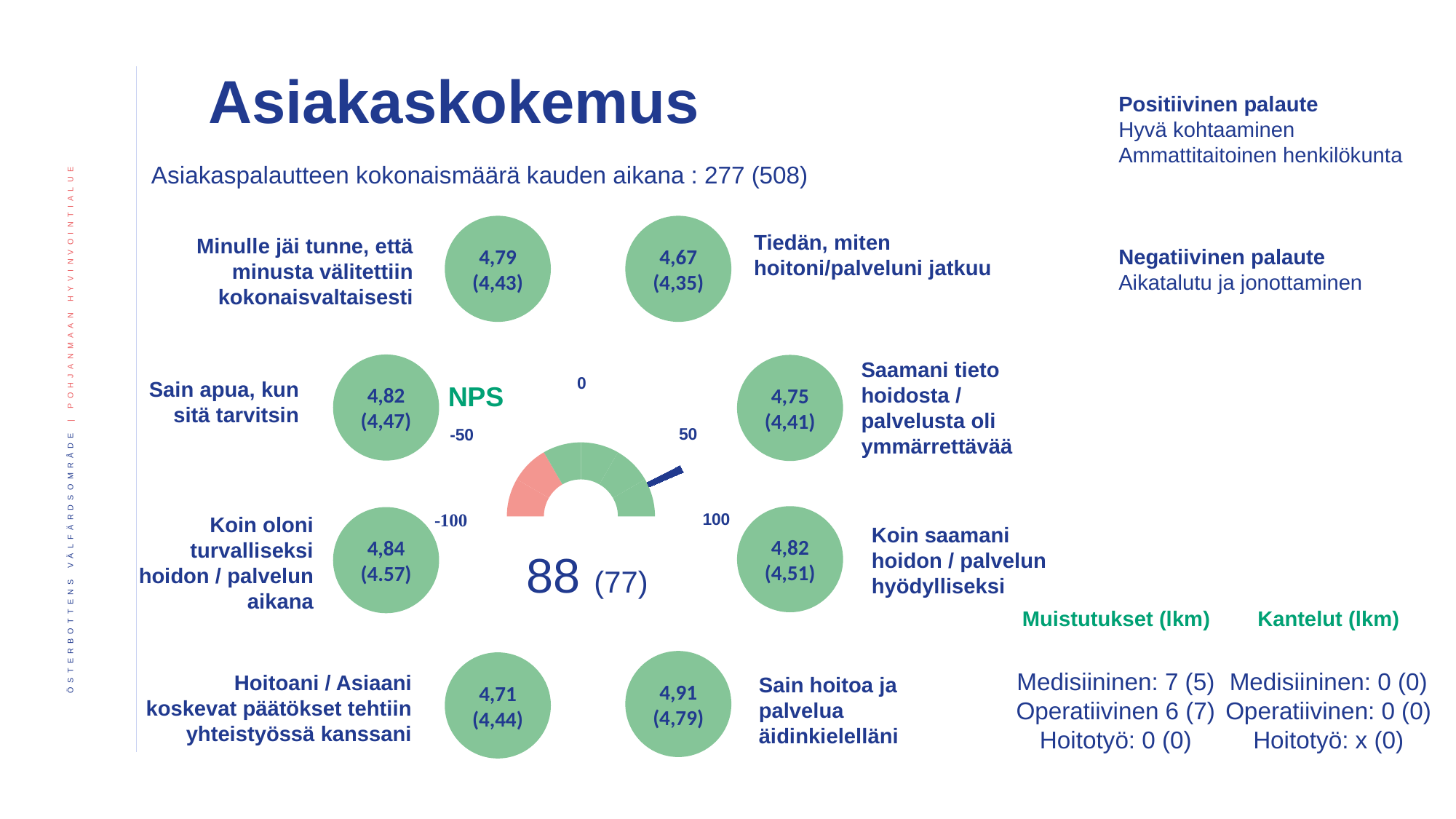
What is the score shown for 'Tiedän, miten hoitoni/palveluni jatkuu'? 4,67 Is the NPS value on the gauge greater or less than 50? greater What is the previous NPS value shown in parentheses below the gauge? 77 Which statement has the lowest score among the green circles? Tiedän, miten hoitoni/palveluni jatkuu What kind of chart is used to display the NPS? gauge chart What is the minimum value shown on the NPS gauge scale? -100 What is the score shown for 'Sain hoitoa ja palvelua äidinkielelläni'? 4,91 Which statement has the highest score among the green circles? Sain hoitoa ja palvelua äidinkielelläni What is the NPS value shown on the gauge chart? 88 What is the maximum value shown on the NPS gauge scale? 100 How many green score circles are shown on the slide? 8 What is the difference between the current NPS (88) and the previous NPS (77)? 11